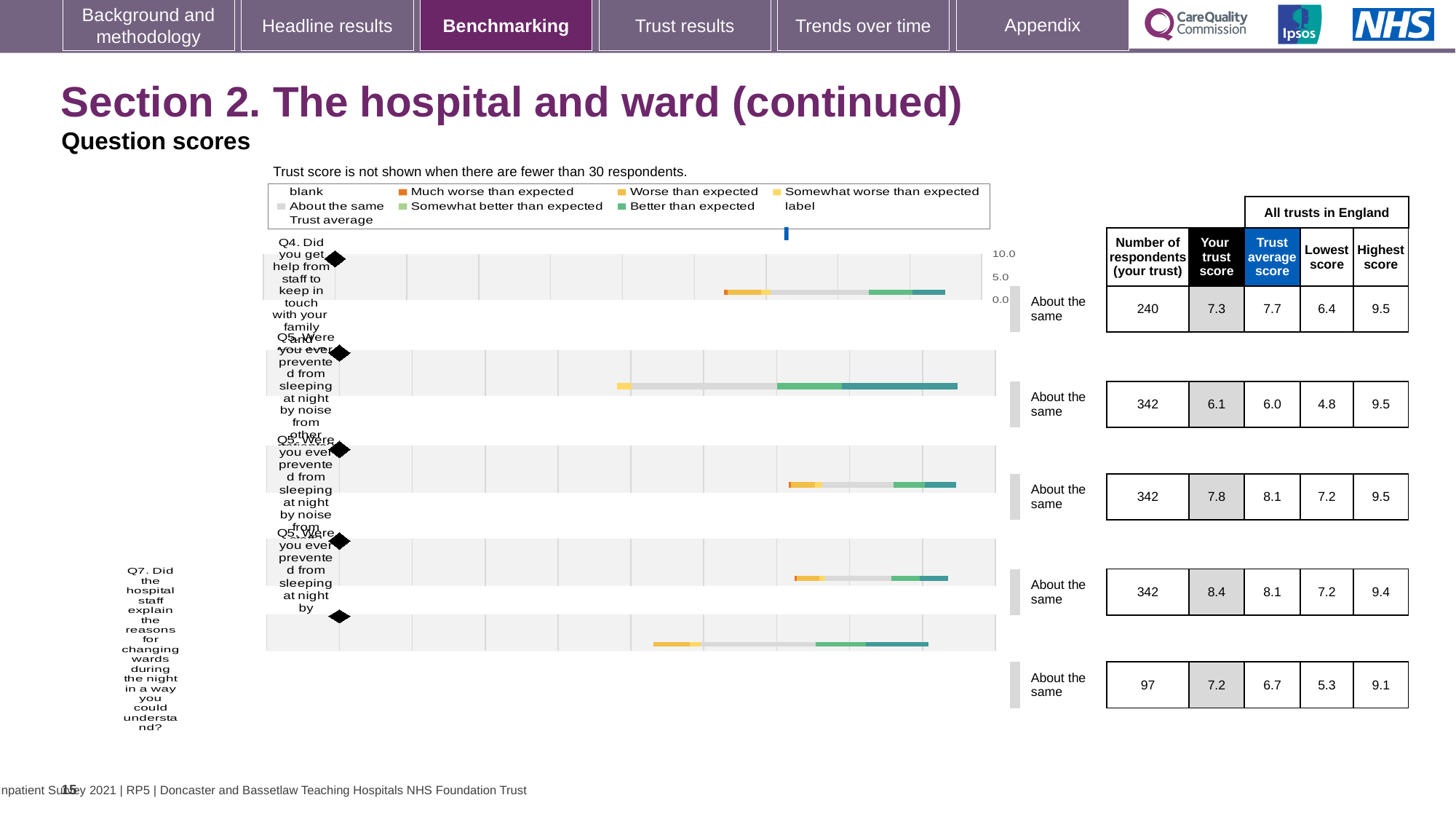
What is the highest 'Your trust score' value shown in the table? 8.4 What is the lowest score among all trusts in England for Q7 (explaining reasons for changing wards during the night)? 5.3 How many question rows (bars) are plotted on the chart? 5 What benchmark category is shown for Q4 (help from staff to keep in touch with family and friends)? About the same What is your trust's score for Q4 (help from staff to keep in touch with family and friends)? 7.3 What kind of chart is shown on the slide? bar chart For Q4, which is larger: your trust score or the trust average score? Trust average score How many respondents answered Q7 (explaining reasons for changing wards during the night) for your trust? 97 According to the table, how many respondents answered Q4 (help from staff to keep in touch with family and friends) for your trust? 240 What is the difference between the highest score and the lowest score for Q4? 3.1 What is the maximum value shown on the chart's score axis? 10.0 What is the trust average score for Q4 (help from staff to keep in touch with family and friends)? 7.7